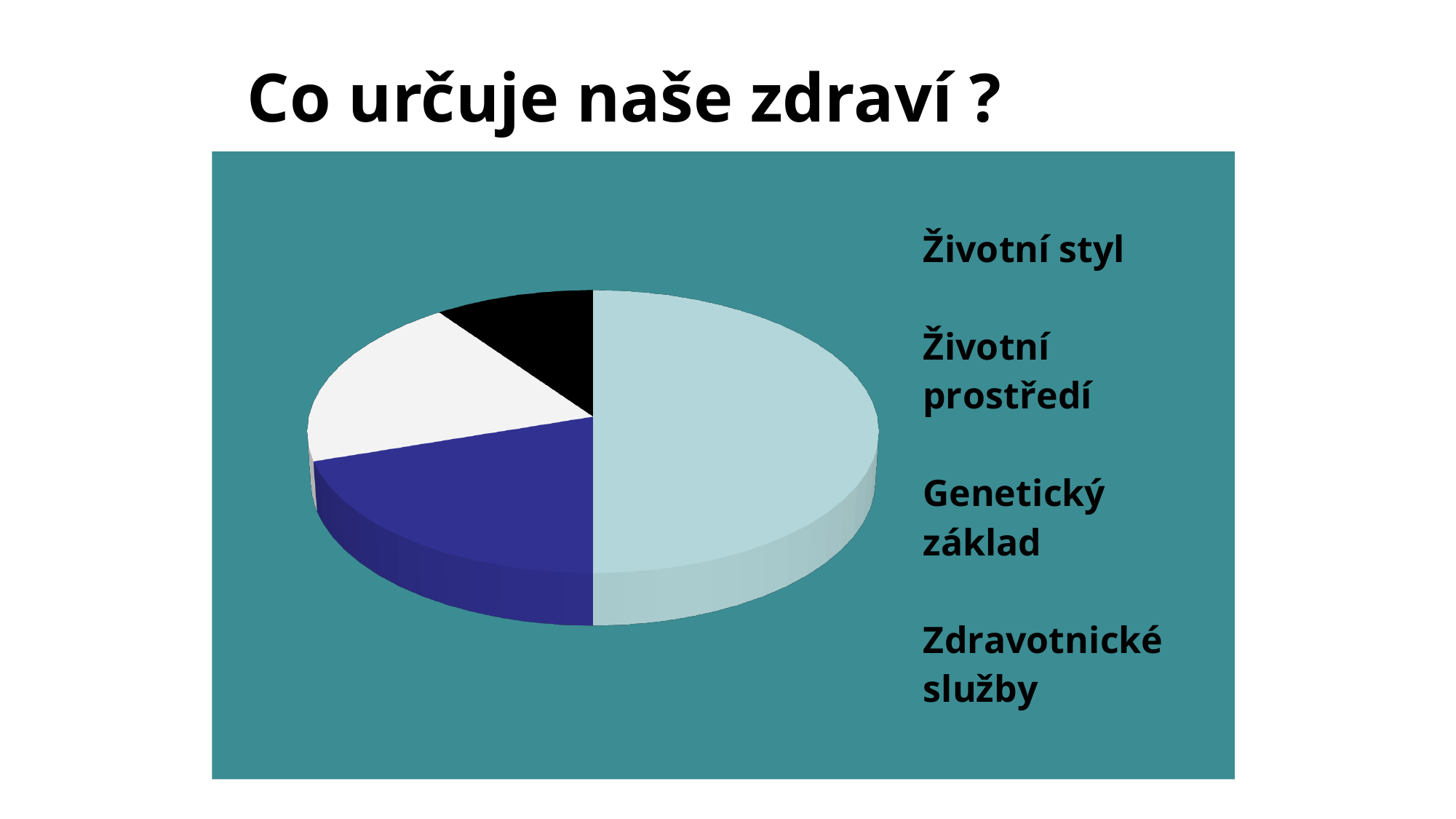
What is the title of the slide containing the chart? Co určuje naše zdraví ? What kind of chart is shown on the slide? pie chart Which colour slice is the largest in the pie chart? light blue How many slices does the pie chart have? 4 How many entries does the legend list? 4 Which colour slice is the smallest in the pie chart? black Which is larger, the light blue slice or the dark blue slice? light blue Which is larger, the white slice or the black slice? white What is the first entry listed in the legend? Životní styl